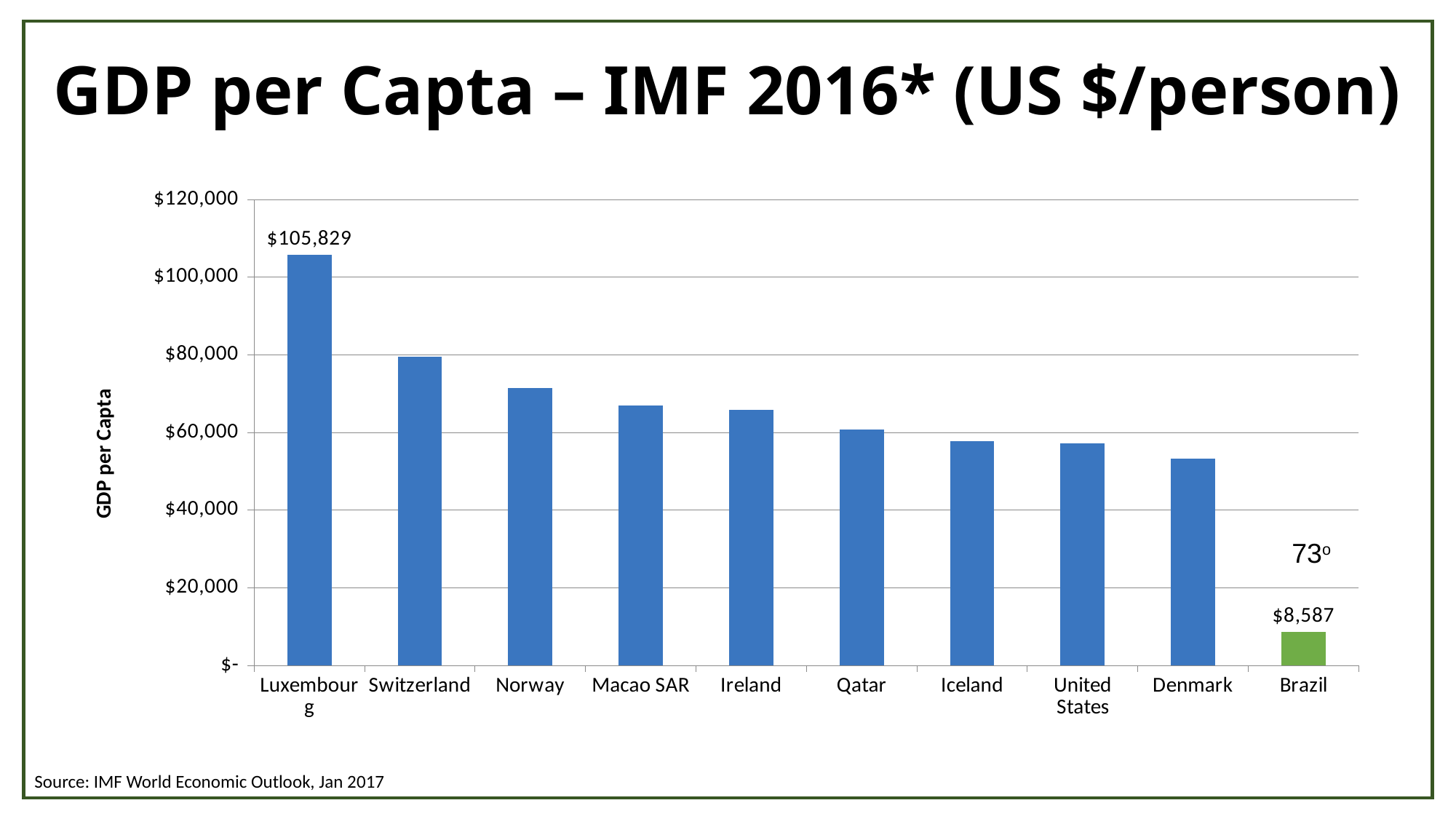
Is the value for Switzerland greater or less than $100,000? less Is the value for Norway greater or less than $60,000? greater What is the difference between the GDP per capita of Luxembourg and Brazil? $97,242 What ranking number is shown above the Brazil bar? 73º Which has a higher GDP per capita, Switzerland or Norway? Switzerland What kind of chart is shown on the slide? Bar chart Is the value for Denmark greater or less than $60,000? less What is the GDP per capita value shown for Brazil? $8,587 Which country has the highest GDP per capita on the chart? Luxembourg What is the GDP per capita value shown for Luxembourg? $105,829 How many countries are shown on the chart? 10 Which country has the lowest GDP per capita on the chart? Brazil